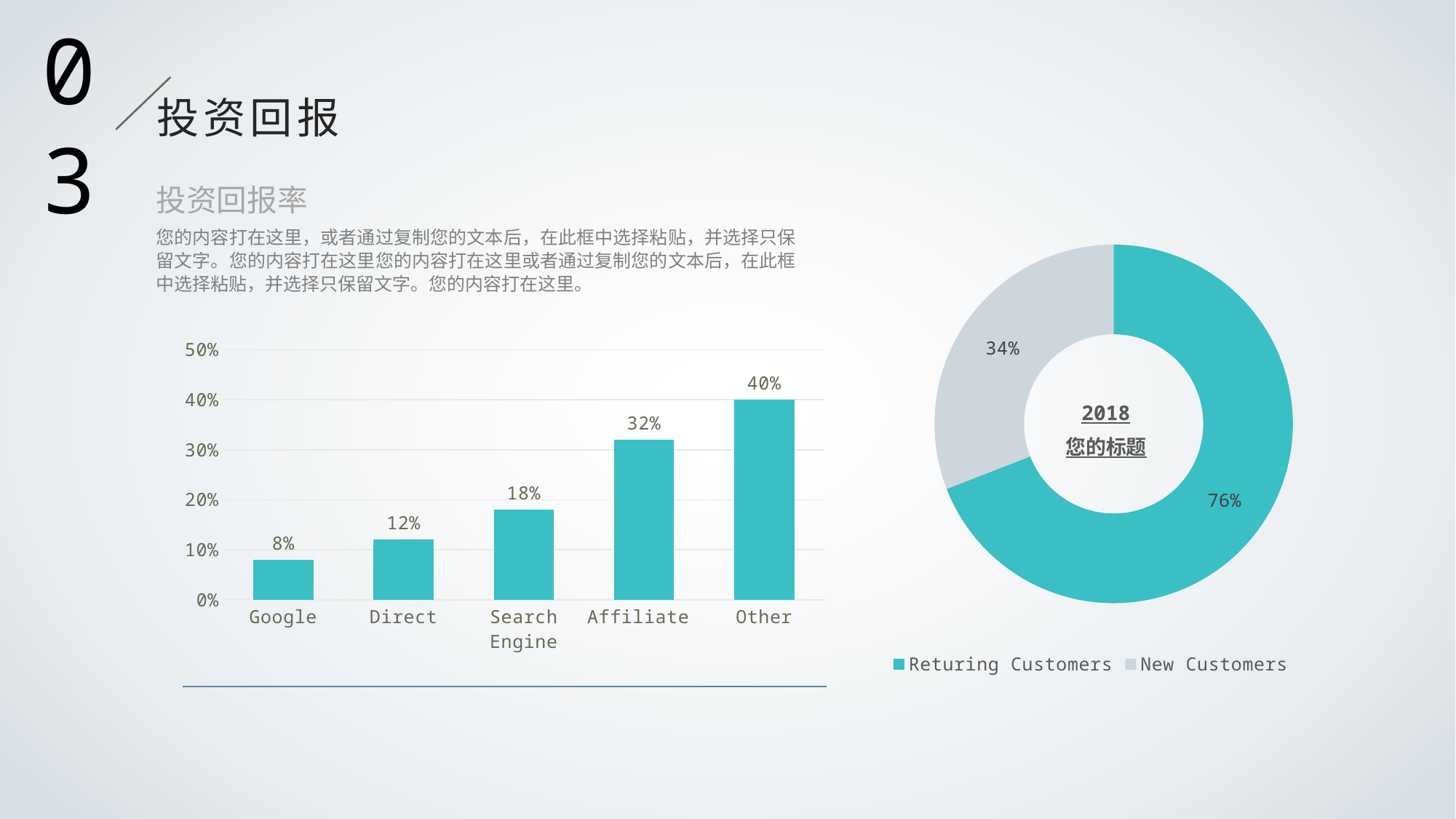
In the bar chart on the left, what is the value for Affiliate? 32% In the bar chart on the left, which category has the lowest value? Google In the bar chart on the left, what is the value for Google? 8% In the bar chart on the left, which is larger, the value for Direct or the value for Affiliate? Affiliate In the donut chart on the right, what is the value shown for New Customers? 34% In the bar chart on the left, how many categories are shown on the x axis? 5 In the bar chart on the left, what is the difference between the values for Other and Search Engine? 22% In the donut chart on the right, what is the value shown for Returing Customers? 76% How many series does the legend of the donut chart on the right list? 2 In the bar chart on the left, which category has the highest value? Other In the bar chart on the left, do the values rise or fall from Google to Other? Rise What kind of chart is shown on the left of the slide? Bar chart